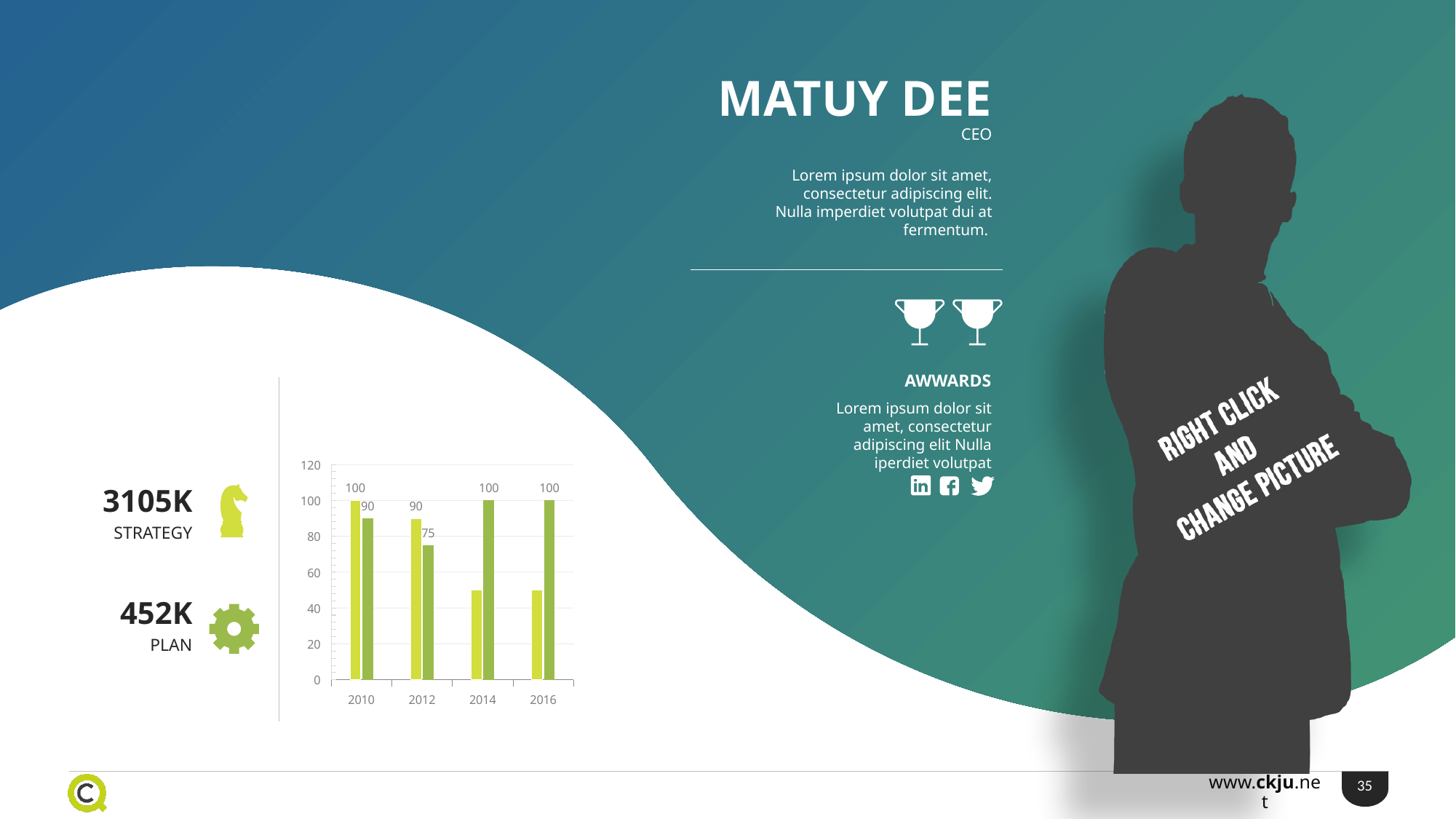
What is the value of the right (darker green) bar for 2010? 90 What type of chart is shown on the slide? bar chart What is the value of the right (darker green) bar for 2016? 100 Is the value of the left (lighter green) bar for 2014 greater or less than 60? less What is the value of the right (darker green) bar for 2014? 100 For 2010, which bar is larger, the left (lighter green) or the right (darker green)? the left (lighter green) bar What is the difference between the left and right bars for 2012? 15 What is the value of the left (lighter green) bar for 2010? 100 What is the value of the right (darker green) bar for 2012? 75 How many years are shown on the x axis of the bar chart? 4 Do the left (lighter green) bars rise or fall from 2010 to 2016? fall What is the value of the left (lighter green) bar for 2012? 90